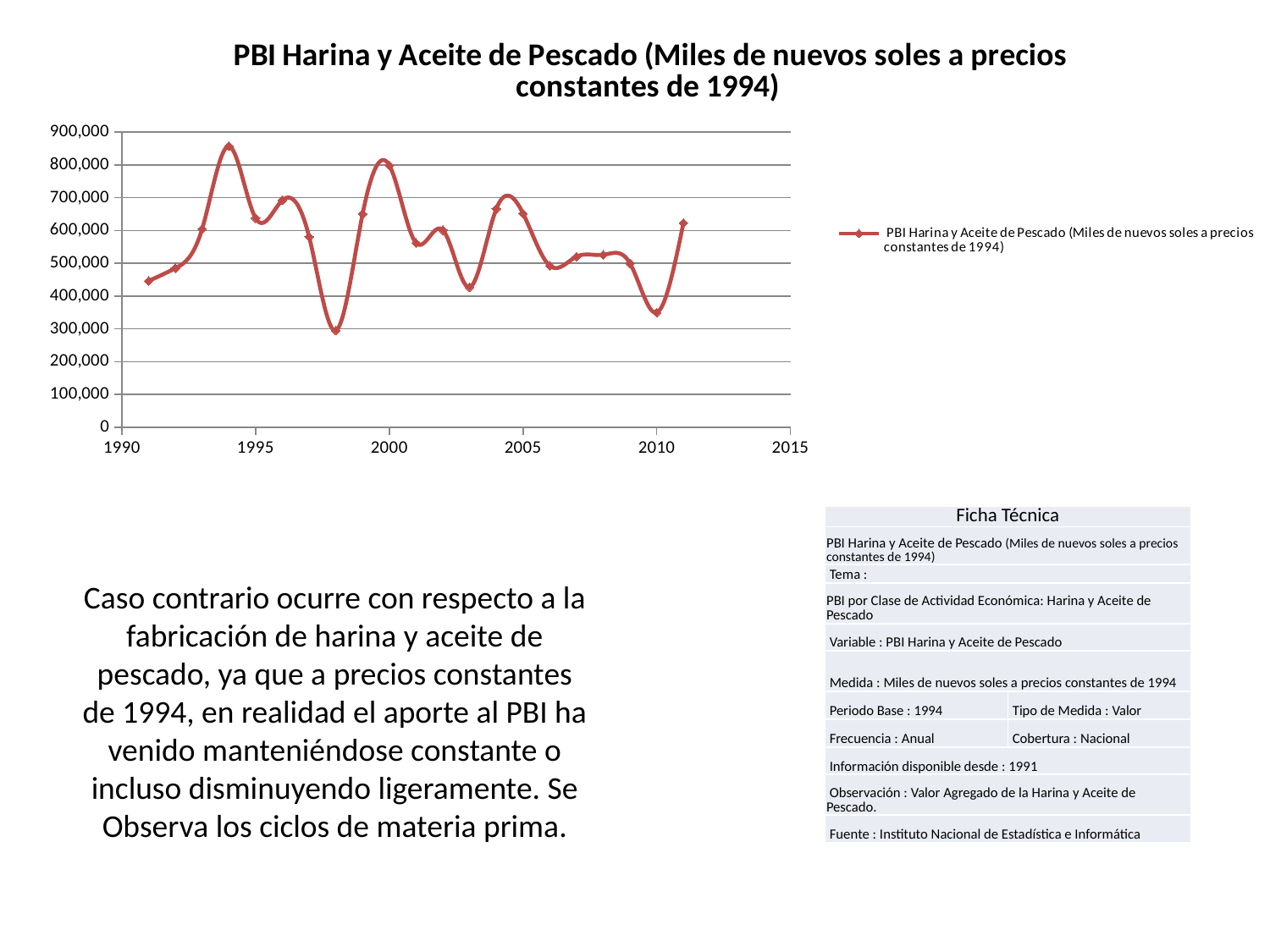
Is the value for 2000 greater or less than 700,000? greater Is the value for 2010 greater or less than 400,000? less Does the series rise or fall between 1991 and 1994? Rise How many series does the legend list? 1 What is the title of the chart? PBI Harina y Aceite de Pescado (Miles de nuevos soles a precios constantes de 1994) Is the value for 1991 greater or less than 500,000? less In which year does the PBI Harina y Aceite de Pescado series reach its highest value? 1994 What kind of chart is shown on the slide? Line chart Which year has the larger value, 1994 or 2000? 1994 In which year does the PBI Harina y Aceite de Pescado series reach its lowest value? 1998